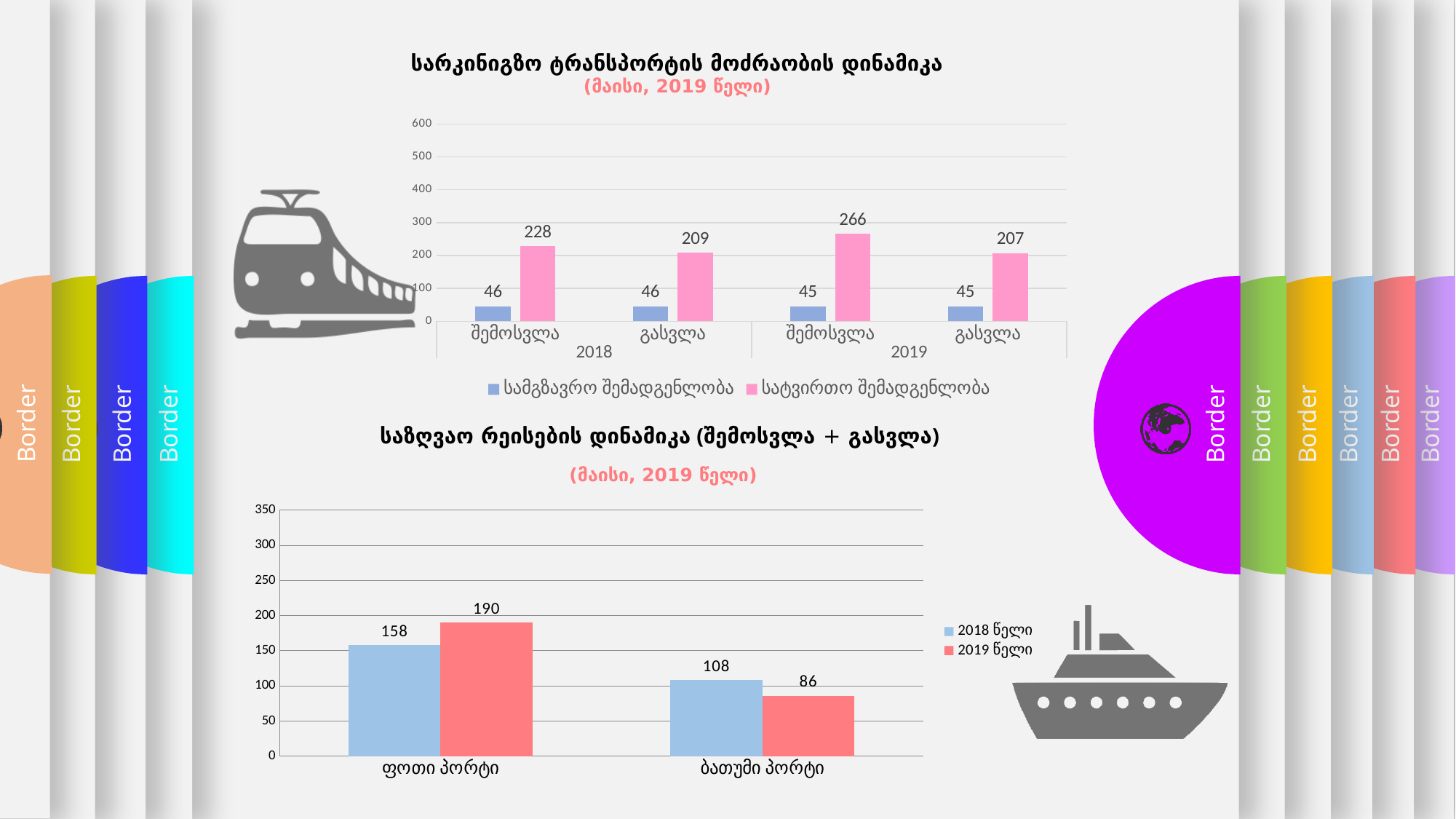
In the top chart, what is the value of სამგზავრო შემადგენლობა for გასვლა in 2018? 46 In the top chart, is the value of სატვირთო შემადგენლობა for გასვლა in 2019 greater or less than 300? less What type of chart is the bottom chart? bar chart In the top chart, how many series does the legend list? 2 In the top chart, which category has the highest value for სატვირთო შემადგენლობა? შემოსვლა 2019 In the bottom chart, what is the value for ბათუმი პორტი in 2018 წელი? 108 In the bottom chart, which is larger for ბათუმი პორტი: 2018 წელი or 2019 წელი? 2018 წელი In the top chart, what is the difference between სატვირთო შემადგენლობა for შემოსვლა in 2018 and გასვლა in 2018? 19 In the bottom chart, what is the difference between the 2019 წელი and 2018 წელი values for ფოთი პორტი? 32 In the bottom chart, how many port categories are shown on the x axis? 2 In the bottom chart (საზღვაო რეისების დინამიკა), what is the value for ფოთი პორტი in 2019 წელი? 190 In the top chart (სარკინიგზო ტრანსპორტის მოძრაობის დინამიკა), what is the value of სატვირთო შემადგენლობა for შემოსვლა in 2019? 266